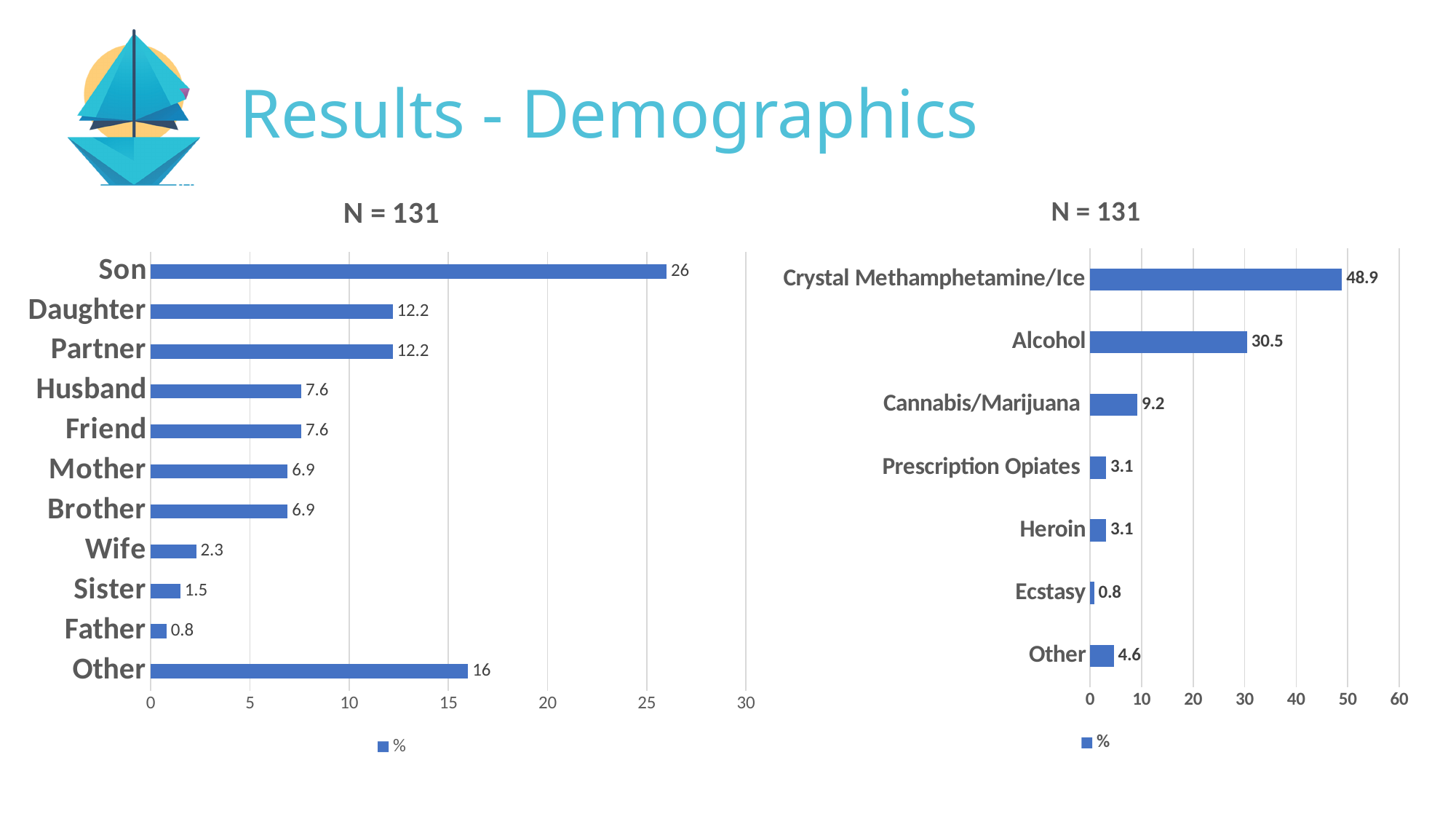
How many categories are shown in the left chart (relationships)? 11 In the left chart (relationships), which category has the lowest value? Father In the right chart (substances), which category has the highest value? Crystal Methamphetamine/Ice In the left chart (relationships), what is the value for Son? 26 How many categories are shown in the right chart (substances)? 7 What is the title shown above each chart? N = 131 In the right chart (substances), which is larger, Cannabis/Marijuana or Other? Cannabis/Marijuana In the right chart (substances), what is the difference between Crystal Methamphetamine/Ice and Alcohol? 18.4 What kind of chart is the right chart (substances)? Bar chart In the left chart (relationships), which is larger, Wife or Sister? Wife In the right chart (substances), what is the value for Alcohol? 30.5 In the left chart (relationships), what is the difference between Son and Other? 10